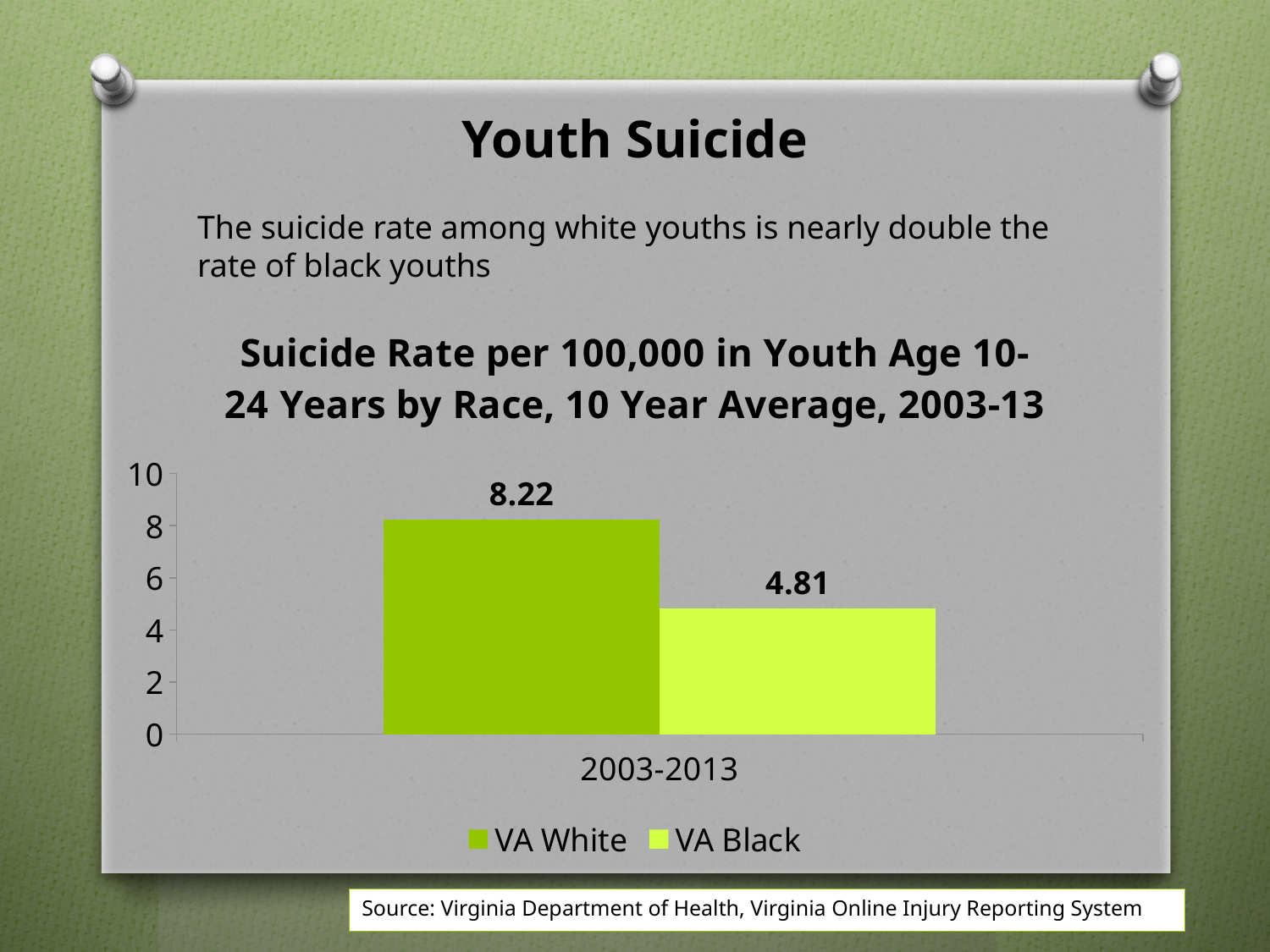
How many series does the chart legend list? 2 What kind of chart is shown on the slide? Bar chart Which series has the higher suicide rate, VA White or VA Black? VA White What is the difference between the VA White and VA Black suicide rates shown in the chart? 3.41 What is the highest value shown on the chart's y axis? 10 What is the suicide rate per 100,000 for VA Black youths in the chart? 4.81 Is the VA Black suicide rate greater or less than 6? less Which series has the lower suicide rate in the chart? VA Black Is the VA White suicide rate greater or less than 8? greater What is the title of the chart? Suicide Rate per 100,000 in Youth Age 10-24 Years by Race, 10 Year Average, 2003-13 What is the category label shown on the x axis of the chart? 2003-2013 What is the suicide rate per 100,000 for VA White youths in the chart? 8.22